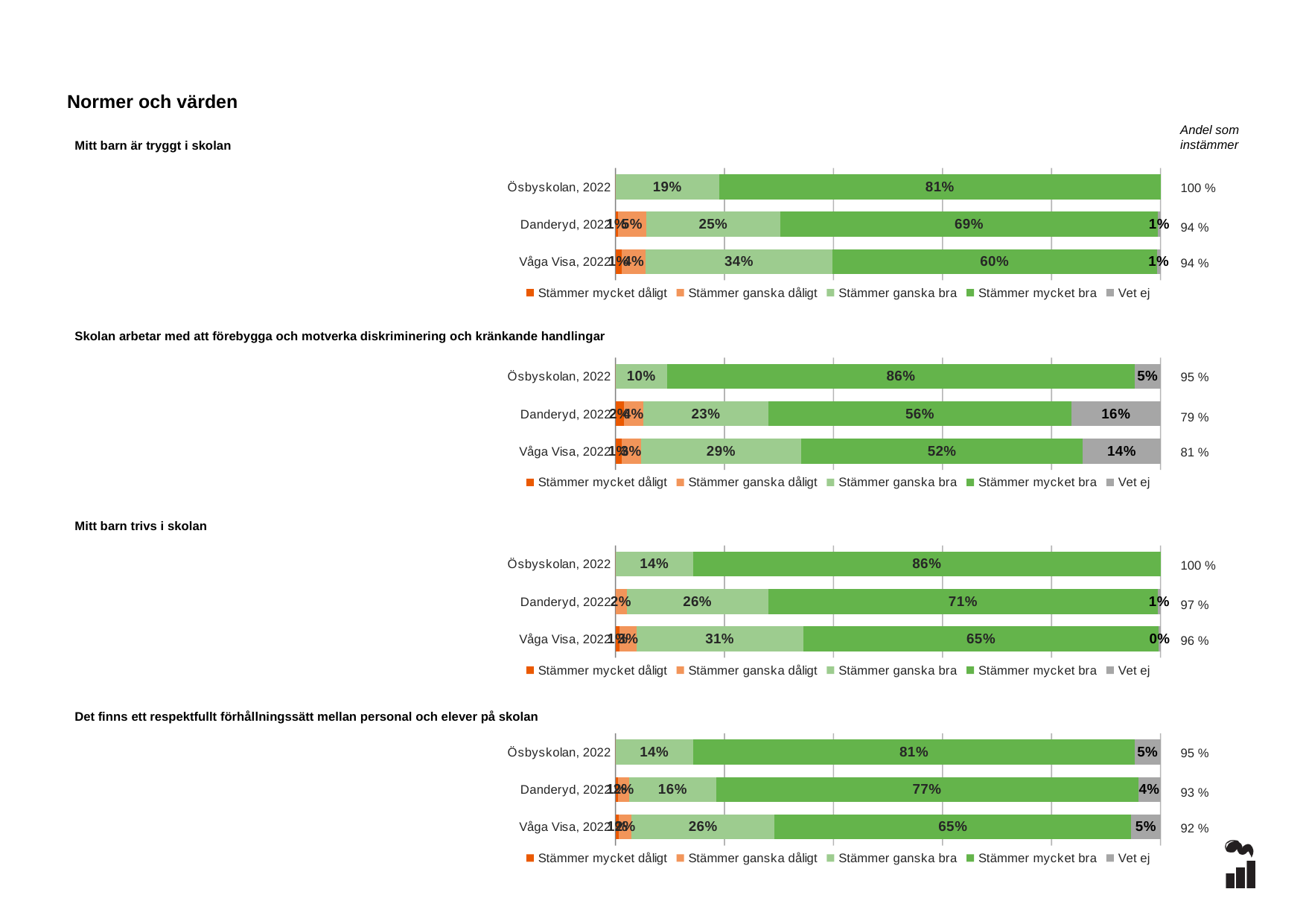
How many categories (bars) are shown in the chart 'Mitt barn är tryggt i skolan'? 3 In the chart 'Skolan arbetar med att förebygga och motverka diskriminering och kränkande handlingar', what is the 'Vet ej' value for Danderyd, 2022? 16% In the chart 'Det finns ett respektfullt förhållningssätt mellan personal och elever på skolan', which category has the lowest 'Stämmer mycket bra' value? Våga Visa, 2022 In the chart 'Mitt barn trivs i skolan', which is larger: 'Stämmer ganska bra' for Danderyd, 2022 or for Våga Visa, 2022? Våga Visa, 2022 In the chart 'Mitt barn är tryggt i skolan', what is the value of 'Stämmer mycket bra' for Ösbyskolan, 2022? 81% What kind of chart is used for 'Skolan arbetar med att förebygga och motverka diskriminering och kränkande handlingar'? Stacked bar chart How many series does the legend of the chart 'Mitt barn trivs i skolan' list? 5 In the chart 'Mitt barn är tryggt i skolan', what is the value of 'Stämmer ganska bra' for Våga Visa, 2022? 34% In the chart 'Mitt barn trivs i skolan', what is the difference between the 'Stämmer mycket bra' values for Ösbyskolan, 2022 and Våga Visa, 2022? 21% In the chart 'Skolan arbetar med att förebygga och motverka diskriminering och kränkande handlingar', what is the 'Andel som instämmer' value shown for Danderyd, 2022? 79 % In the chart 'Skolan arbetar med att förebygga och motverka diskriminering och kränkande handlingar', which category has the highest 'Stämmer mycket bra' value? Ösbyskolan, 2022 In the chart 'Det finns ett respektfullt förhållningssätt mellan personal och elever på skolan', what is the 'Stämmer mycket bra' value for Danderyd, 2022? 77%